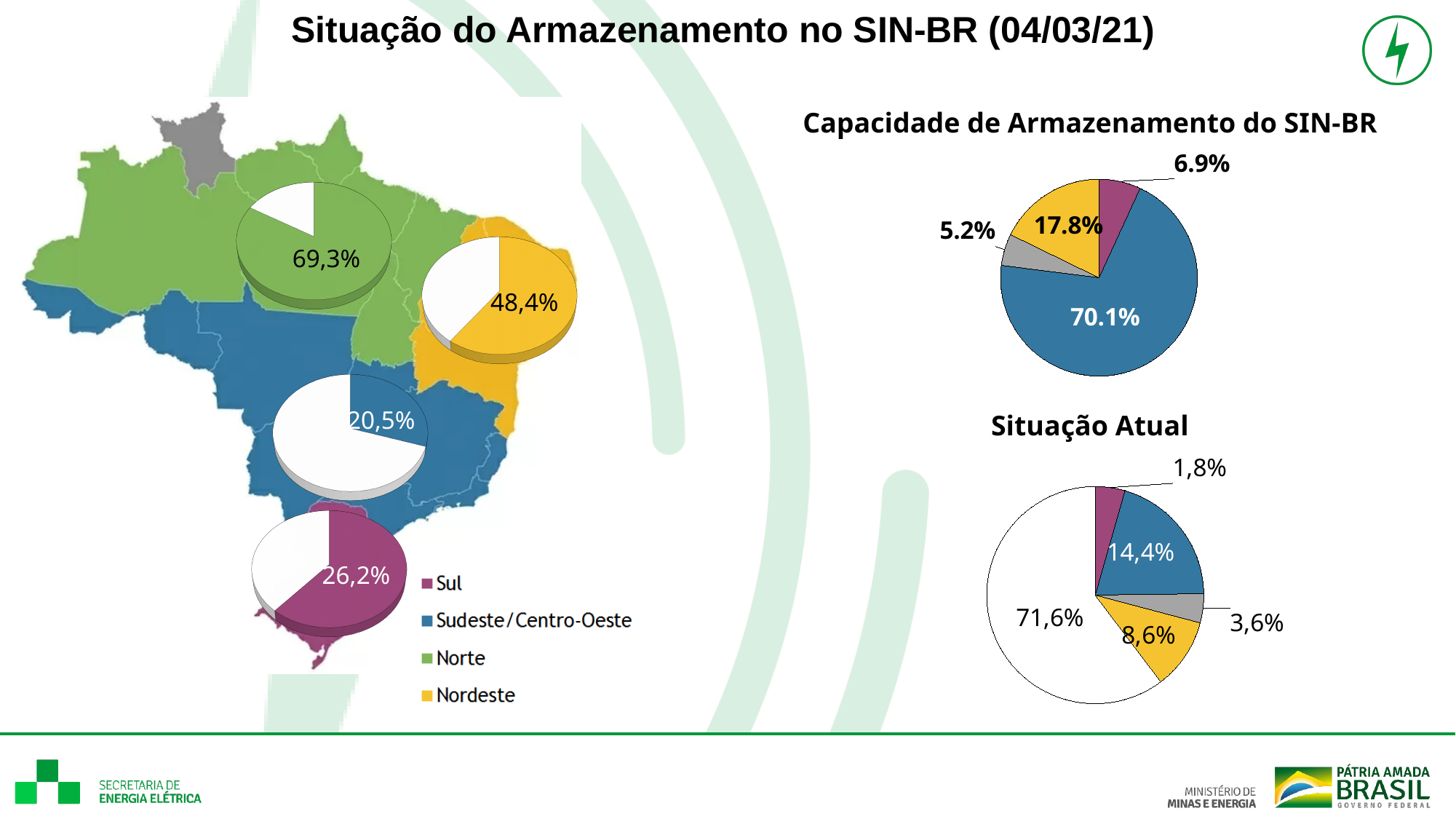
In the 'Capacidade de Armazenamento do SIN-BR' pie chart, what is the value of the smallest slice? 5.2% What kind of chart is 'Situação Atual'? pie chart In the 'Capacidade de Armazenamento do SIN-BR' pie chart, what share does the yellow slice have? 17.8% In the 'Capacidade de Armazenamento do SIN-BR' pie chart, what share does the purple slice have? 6.9% In the 'Situação Atual' pie chart, what is the value of the smallest slice? 1,8% In the 'Capacidade de Armazenamento do SIN-BR' pie chart, what is the value of the largest slice? 70.1% In the 'Situação Atual' pie chart, what is the value of the blue slice? 14,4% In the 'Situação Atual' pie chart, which is larger, the yellow slice or the grey slice? the yellow slice On the map on the left, what percentage is shown in the pie chart over the Sul region? 26,2% In the 'Situação Atual' pie chart, what is the value of the largest slice? 71,6% How many slices does the 'Capacidade de Armazenamento do SIN-BR' pie chart have? 4 On the map on the left, what percentage is shown in the pie chart over the Norte region? 69,3%